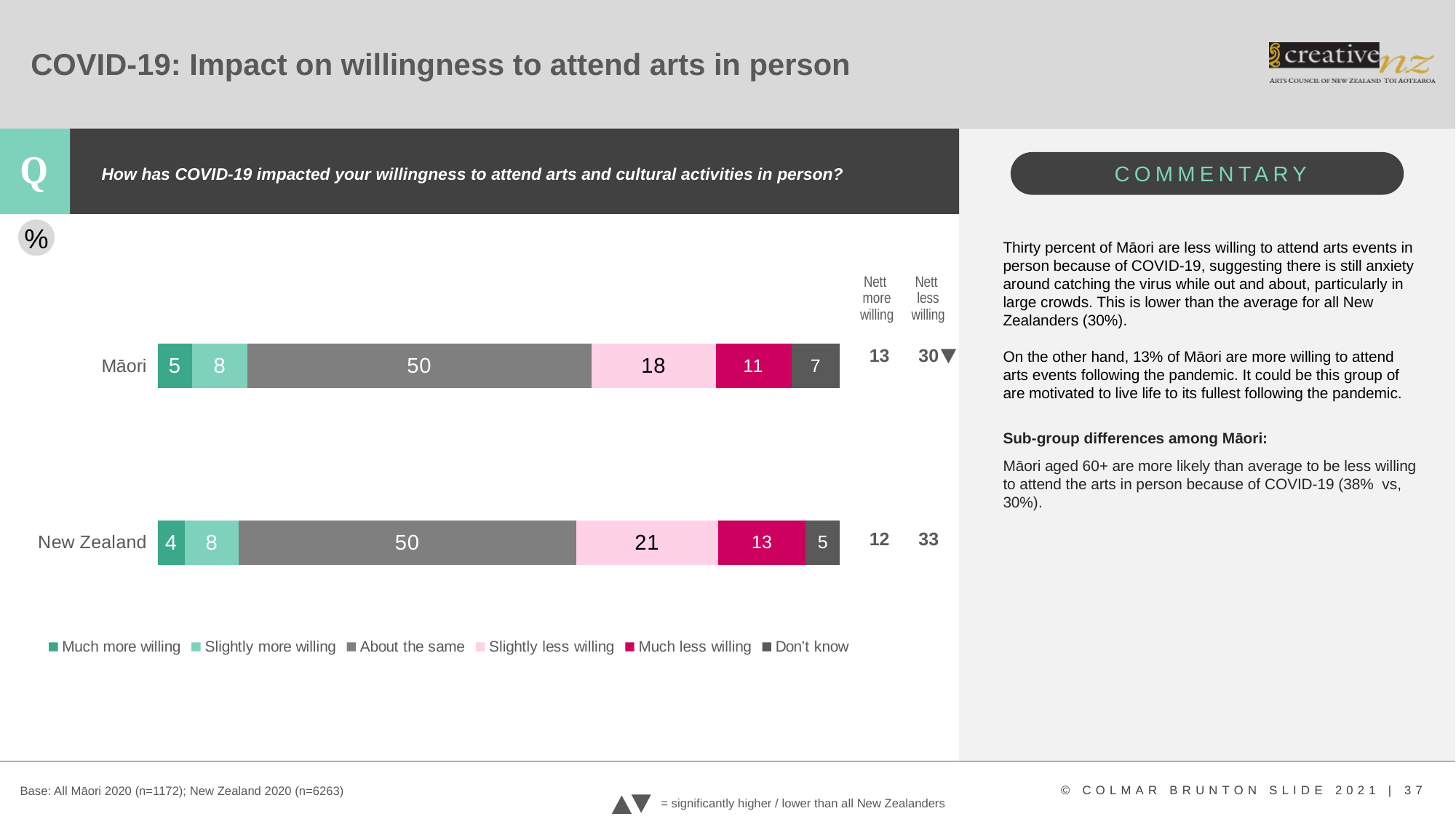
What is the 'Slightly less willing' value for New Zealand? 21 What is the 'Nett more willing' figure for New Zealand? 12 What percentage of Māori said they are 'About the same' in willingness to attend arts in person? 50 What is the difference between the 'Slightly less willing' values for New Zealand and Māori? 3 How many categories (groups) are plotted in the chart? 2 Which response category has the largest share for Māori? About the same How many series does the legend list? 6 What is the 'Nett less willing' figure for Māori? 30 What is the 'Much less willing' value for Māori? 11 What type of chart is shown on the slide? Stacked bar chart What is the 'Don't know' value for New Zealand? 5 Which category has the higher 'Much more willing' value, Māori or New Zealand? Māori